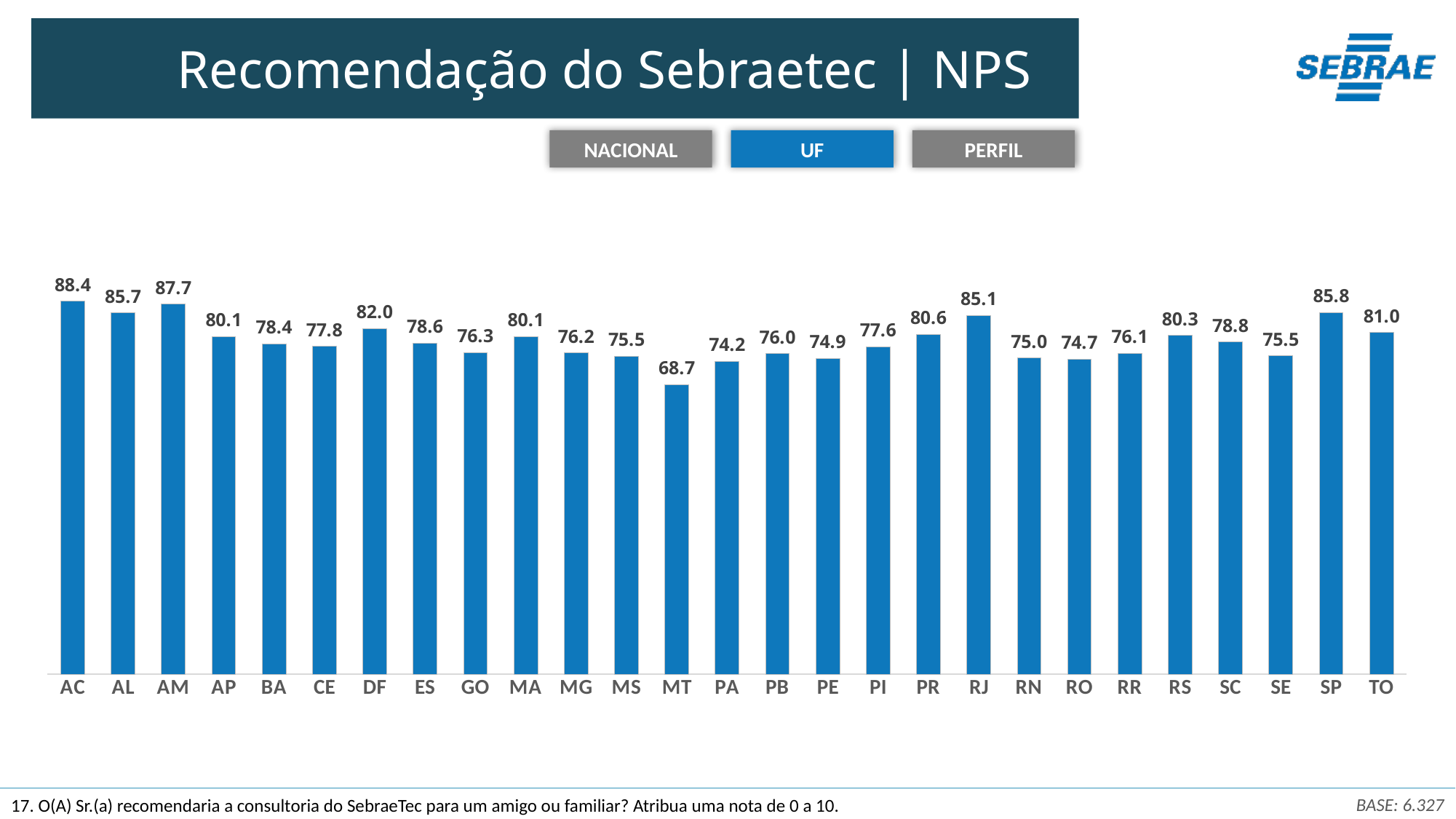
What is the NPS value for PI? 77.6 Which has a higher NPS value, AM or AL? AM What is the NPS value for DF? 82.0 What is the difference between the NPS values for AC and MT? 19.7 What is the NPS value for SP? 85.8 Which has a higher NPS value, PR or RS? PR Which UF has the lowest NPS value? MT How many UFs are shown on the x axis of the chart? 27 What kind of chart is shown on the slide? Bar chart Which UF has the highest NPS value? AC What is the NPS value for MT? 68.7 What is the difference between the NPS values for SP and RJ? 0.7